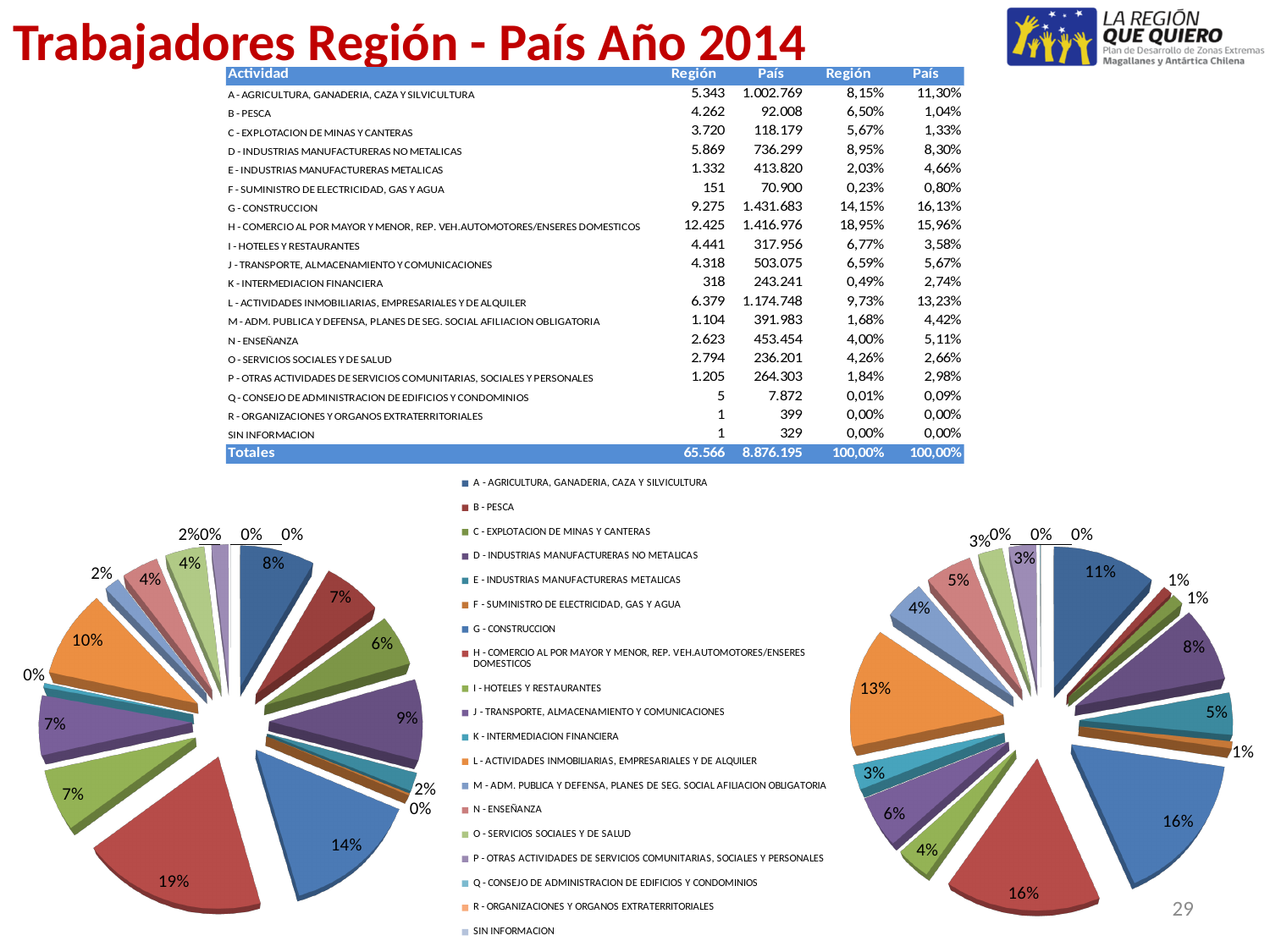
In the left pie chart, what share is shown for G - CONSTRUCCION? 14% In the left pie chart, what share is shown for L - ACTIVIDADES INMOBILIARIAS, EMPRESARIALES Y DE ALQUILER? 10% In the right pie chart, what is the difference in percentage points between the D - INDUSTRIAS MANUFACTURERAS NO METALICAS slice and the E - INDUSTRIAS MANUFACTURERAS METALICAS slice? 3 percentage points In the right pie chart, what share is shown for A - AGRICULTURA, GANADERIA, CAZA Y SILVICULTURA? 11% What kind of chart is shown at the bottom left of the slide? pie chart In the left pie chart, which slice is larger: G - CONSTRUCCION or L - ACTIVIDADES INMOBILIARIAS, EMPRESARIALES Y DE ALQUILER? G - CONSTRUCCION In the left pie chart, which category has the largest slice? H - COMERCIO AL POR MAYOR Y MENOR, REP. VEH.AUTOMOTORES/ENSERES DOMESTICOS In the right pie chart, which slice is larger: L - ACTIVIDADES INMOBILIARIAS, EMPRESARIALES Y DE ALQUILER or A - AGRICULTURA, GANADERIA, CAZA Y SILVICULTURA? L - ACTIVIDADES INMOBILIARIAS, EMPRESARIALES Y DE ALQUILER In the left pie chart, what is the difference in percentage points between the H - COMERCIO slice and the G - CONSTRUCCION slice? 5 percentage points How many categories does the legend between the two pie charts list? 19